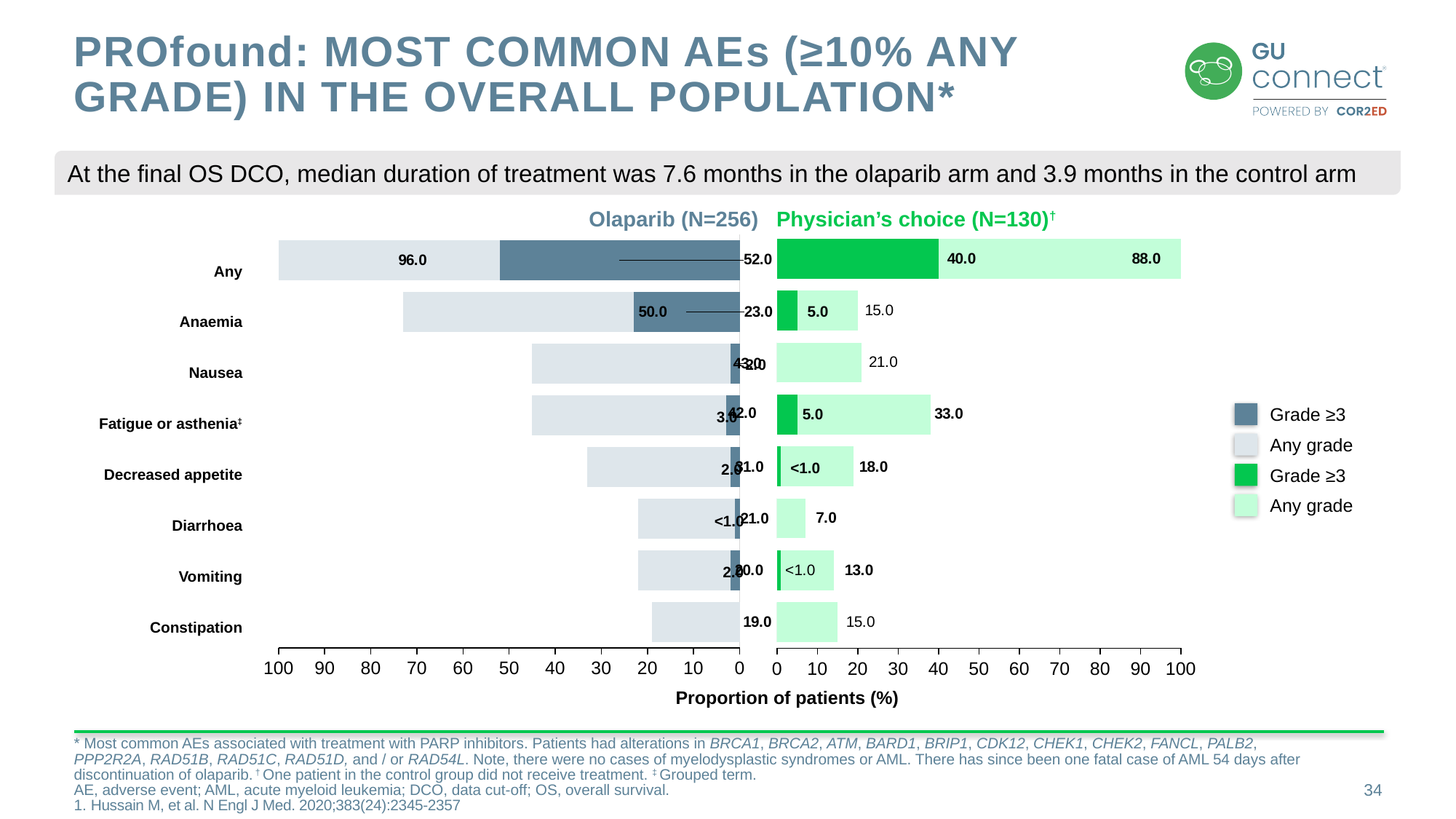
What is the Grade ≥3 value for 'Any' adverse event in the Physician's choice (N=130) arm? 40.0 What is the any-grade value for Fatigue or asthenia in the Physician's choice arm? 33.0 What is the any-grade value for Constipation in the Olaparib arm? 19.0 Which adverse event category has the lowest any-grade value in the Physician's choice arm? Diarrhoea What is the any-grade value for 'Any' adverse event in the Olaparib (N=256) arm? 96.0 Which arm has the higher any-grade value for Anaemia, Olaparib or Physician's choice? Olaparib How many entries does the legend list? 4 How many adverse event categories are listed on the chart? 8 What is the difference between the any-grade 'Any' adverse event values for the Olaparib arm (96.0) and the Physician's choice arm (88.0)? 8.0 What kind of chart is shown on the slide? Bar chart What is the any-grade value for Anaemia in the Olaparib arm? 50.0 What is the Grade ≥3 value for Anaemia in the Olaparib arm? 23.0